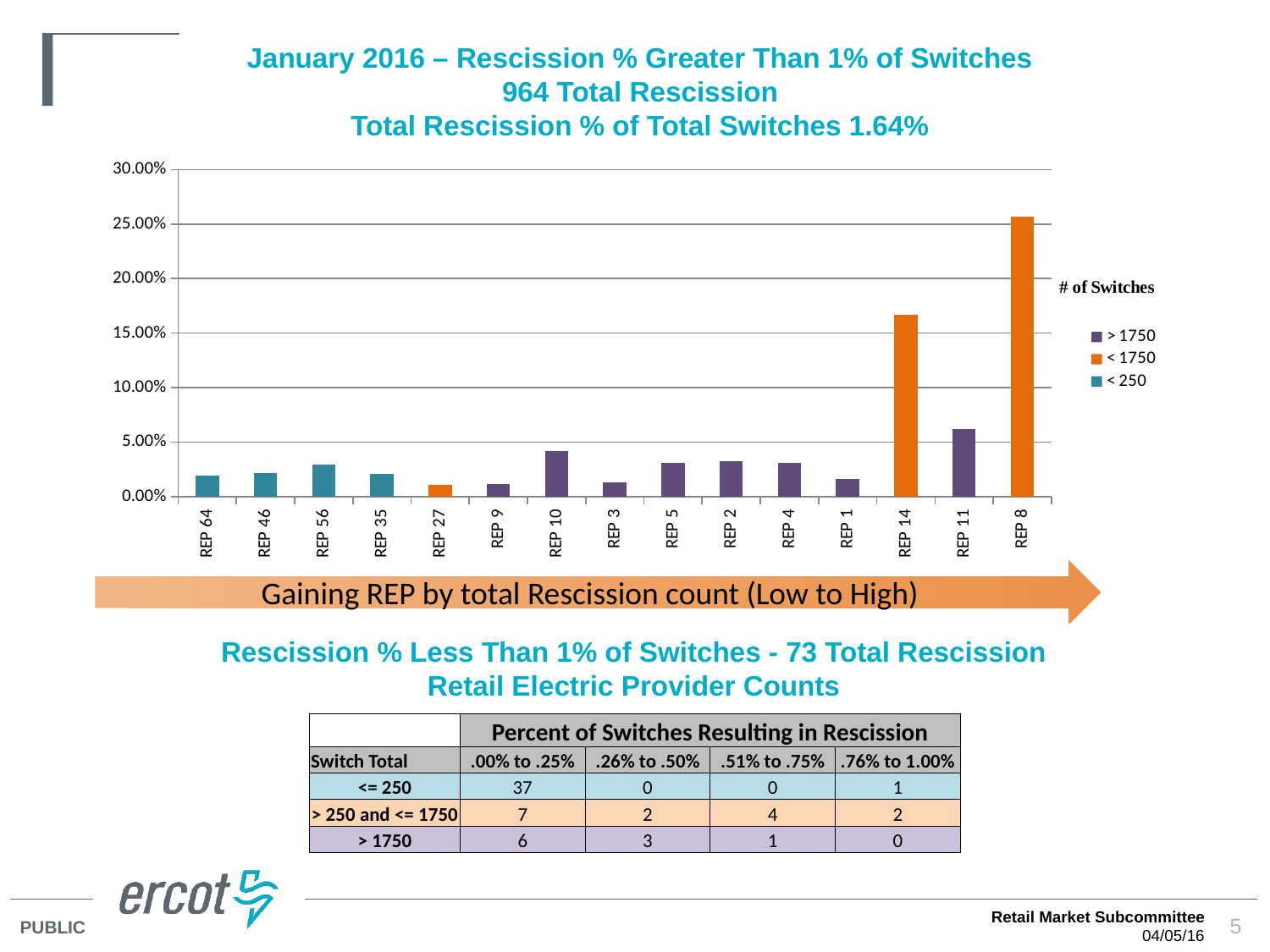
Which REP has the highest rescission percentage in the chart? REP 8 Which has a higher rescission percentage, REP 8 or REP 14? REP 8 Which legend series does the orange colour represent in the chart? < 1750 Is the value for REP 10 greater or less than 5.00%? less How many series does the chart's legend list? 3 Is the value for REP 14 greater or less than 15.00%? greater What is the title of the chart's legend? # of Switches Which has a higher rescission percentage, REP 14 or REP 11? REP 14 How many REP categories are plotted along the x axis of the chart? 15 What kind of chart is shown on the slide? bar chart Is the value for REP 64 greater or less than 5.00%? less